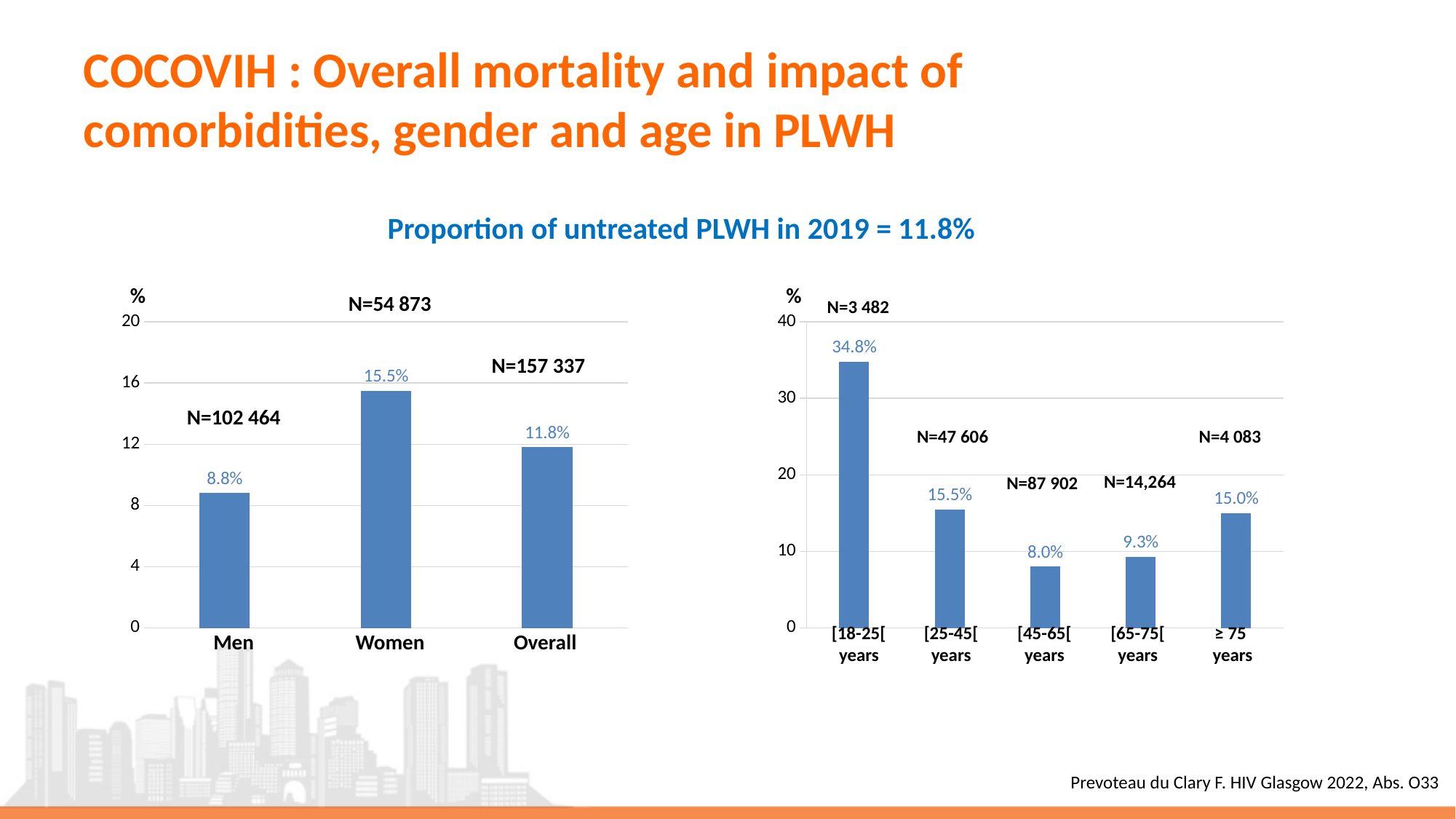
What kind of chart is the right chart (by age)? Bar chart In the right chart (by age), how many age groups are plotted? 5 In the right chart (by age), which is larger, the value for [25-45[ years or ≥ 75 years? [25-45[ years In the right chart (by age), is the value for [65-75[ years greater or less than 10? less In the left chart (by gender), what is the value for Women? 15.5% In the left chart (by gender), what is the value for Men? 8.8% In the right chart (by age), which age group has the highest value? [18-25[ years In the right chart (by age), what is the value for [45-65[ years? 8.0% In the left chart (by gender), what is the difference between the values for Women and Men? 6.7% In the left chart (by gender), which category has the highest value? Women In the left chart (by gender), how many bars are plotted? 3 In the right chart (by age), which age group has the lowest value? [45-65[ years